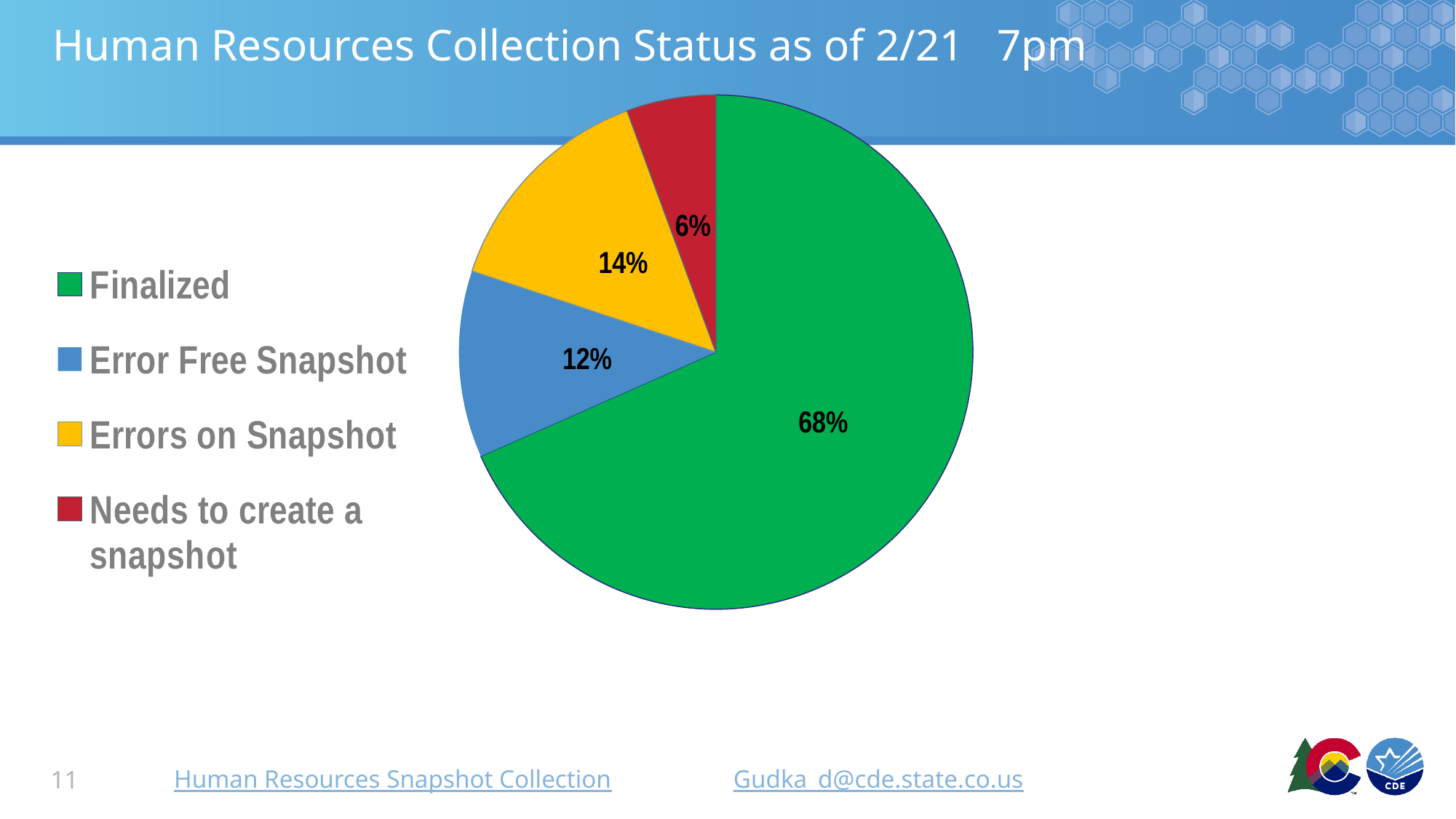
Which category has the largest slice of the pie? Finalized What share of the pie is Errors on Snapshot? 14% Which is larger, Errors on Snapshot or Error Free Snapshot? Errors on Snapshot What share of the pie is Error Free Snapshot? 12% What kind of chart is shown on the slide? pie chart How many categories does the legend list? 4 What share of the pie is Finalized? 68% What is the title of the slide containing the chart? Human Resources Collection Status as of 2/21 7pm What colour is the Errors on Snapshot slice? yellow What share of the pie is Needs to create a snapshot? 6% Which category has the smallest slice of the pie? Needs to create a snapshot What is the difference in percentage points between Finalized and Errors on Snapshot? 54